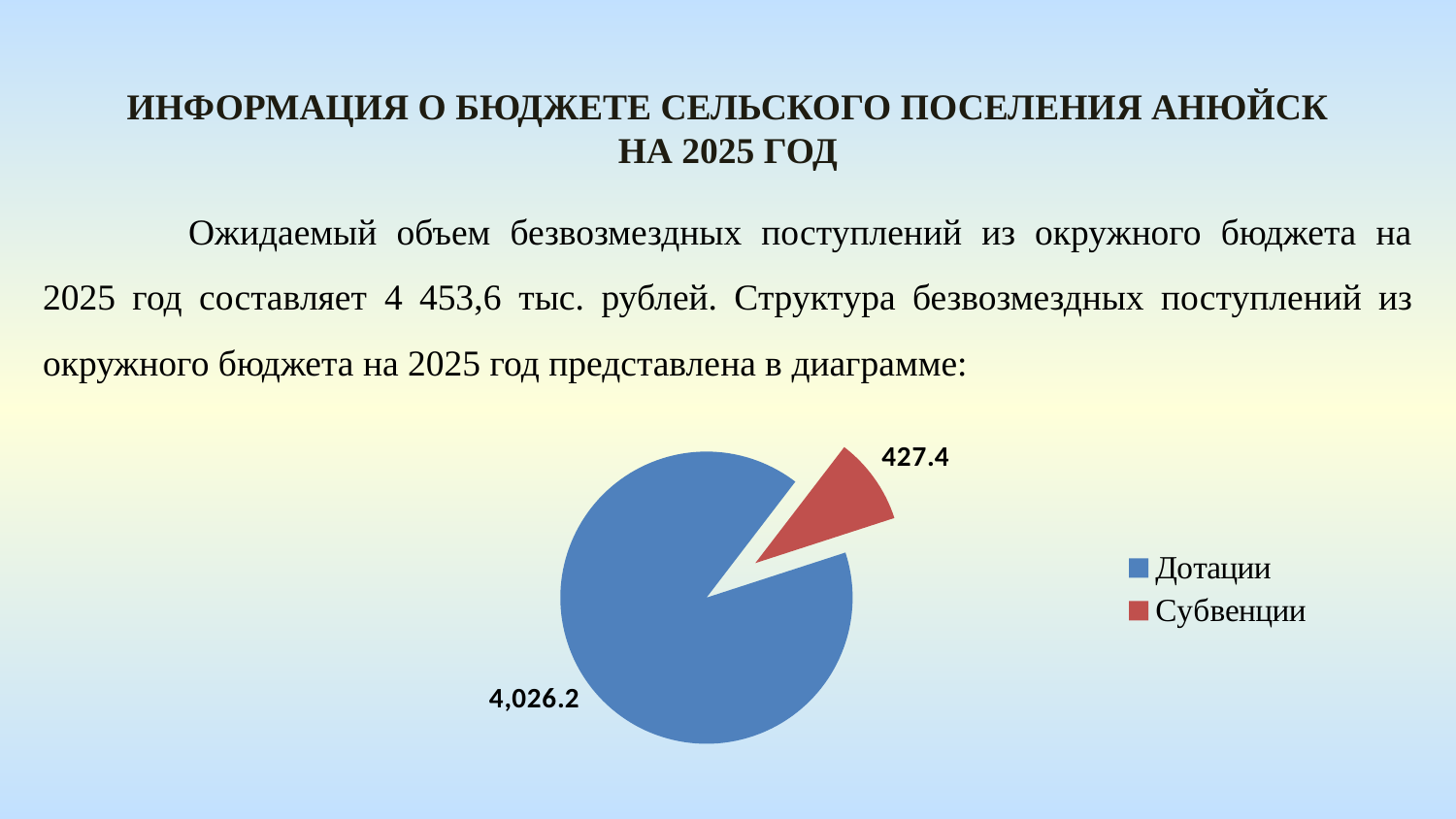
What is the total of the two slices in the pie chart? 4,453.6 Which category has the largest slice in the pie chart? Дотации What kind of chart is shown on the slide? Pie chart What is the difference between the values for Дотации and Субвенции? 3,598.8 What is the value for Субвенции in the pie chart? 427.4 How many entries does the legend list? 2 What share of the pie does Субвенции represent, to the nearest whole percent? 10% Which category has the smallest slice in the pie chart? Субвенции How many slices does the pie chart have? 2 Which is larger, Дотации or Субвенции? Дотации What colour is the Субвенции slice in the pie chart? Red What is the value for Дотации in the pie chart? 4,026.2